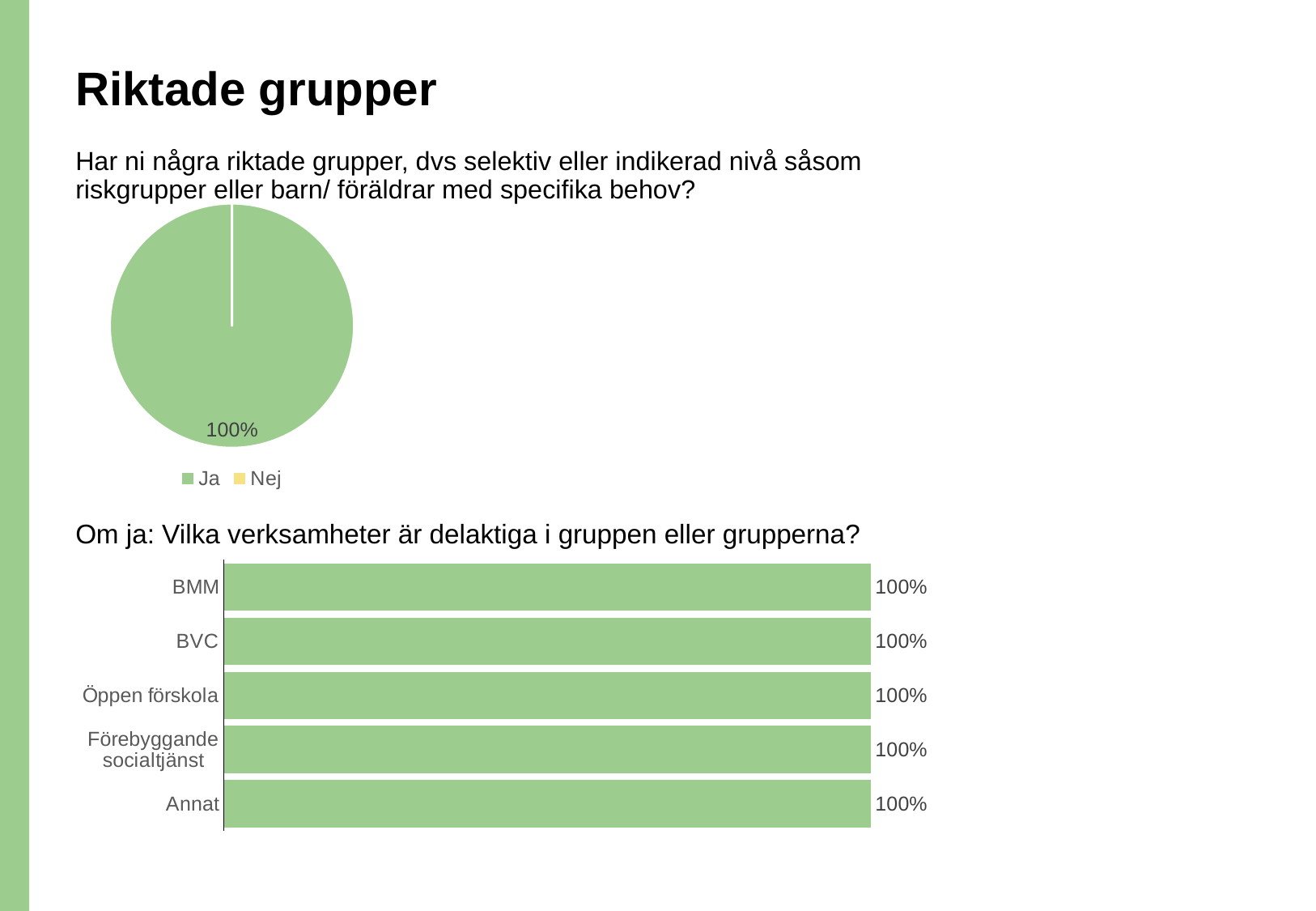
In the top pie chart, what share does the 'Ja' slice have? 100% In the top pie chart, which legend entry is shown in green? Ja How many categories are shown in the bottom bar chart? 5 In the bottom bar chart, what is the value for BMM? 100% In the bottom bar chart, what is the value for Förebyggande socialtjänst? 100% What kind of chart is the bottom chart on the slide? bar chart What kind of chart is the top chart on the slide? pie chart In the bottom bar chart, which category is listed first at the top? BMM In the bottom bar chart, what is the value for Öppen förskola? 100% In the bottom bar chart, what is the value for Annat? 100% How many entries does the legend of the top pie chart list? 2 In the bottom bar chart, what is the difference between the values for BVC and Annat? 0%